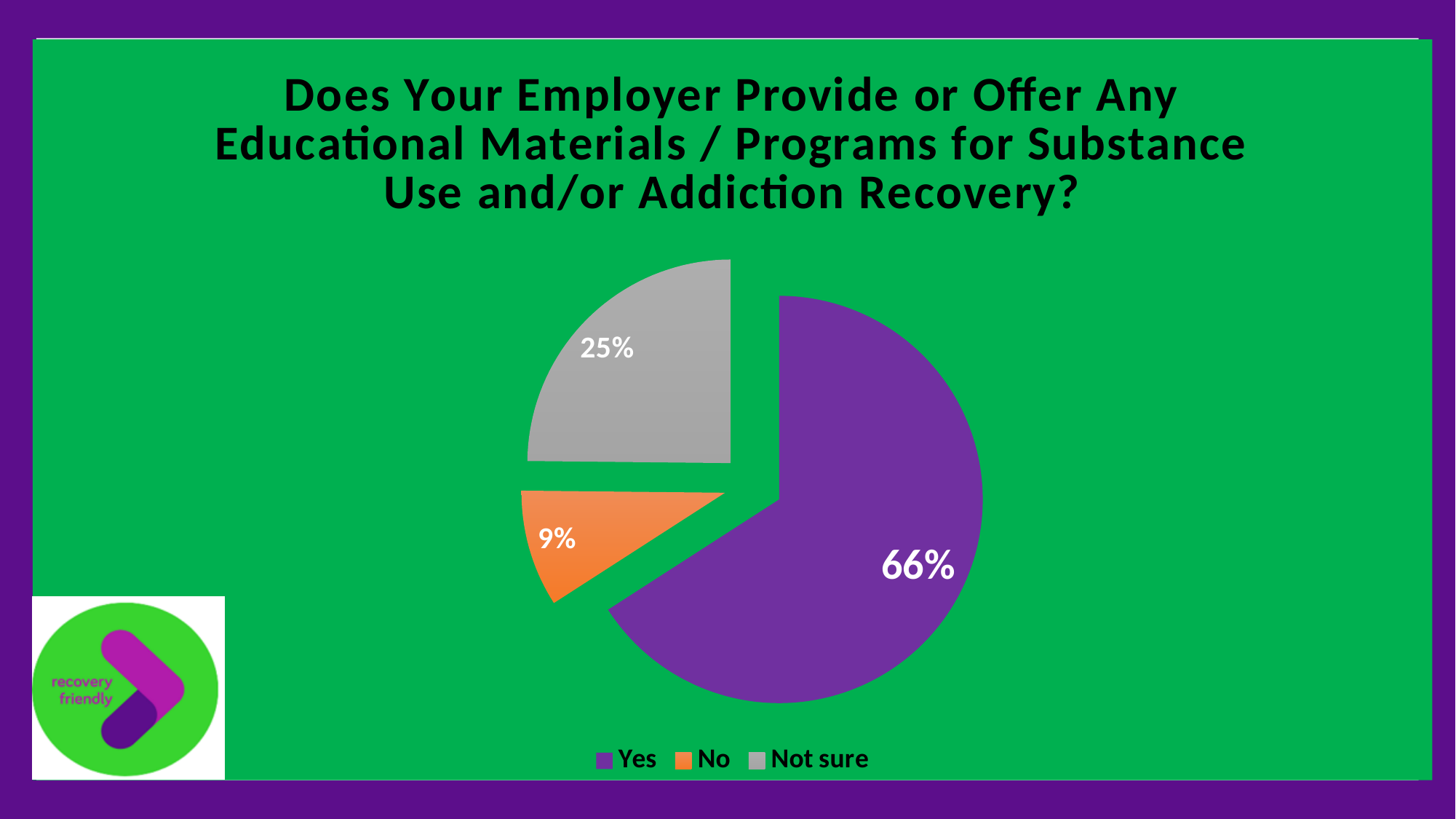
Which is larger, the Not sure slice or the No slice? Not sure Which response has the largest share of the pie? Yes What is the difference in percentage points between the Not sure and No slices? 16 What percentage of respondents answered Yes? 66% What type of chart is shown on the slide? Pie chart How many slices does the pie chart have? 3 What percentage of respondents answered Not sure? 25% What colour is the Yes slice of the pie chart? Purple What is the difference in percentage points between the Yes and Not sure slices? 41 What percentage of respondents answered No? 9% Which response has the smallest share of the pie? No What are the three legend entries of the chart? Yes, No, Not sure